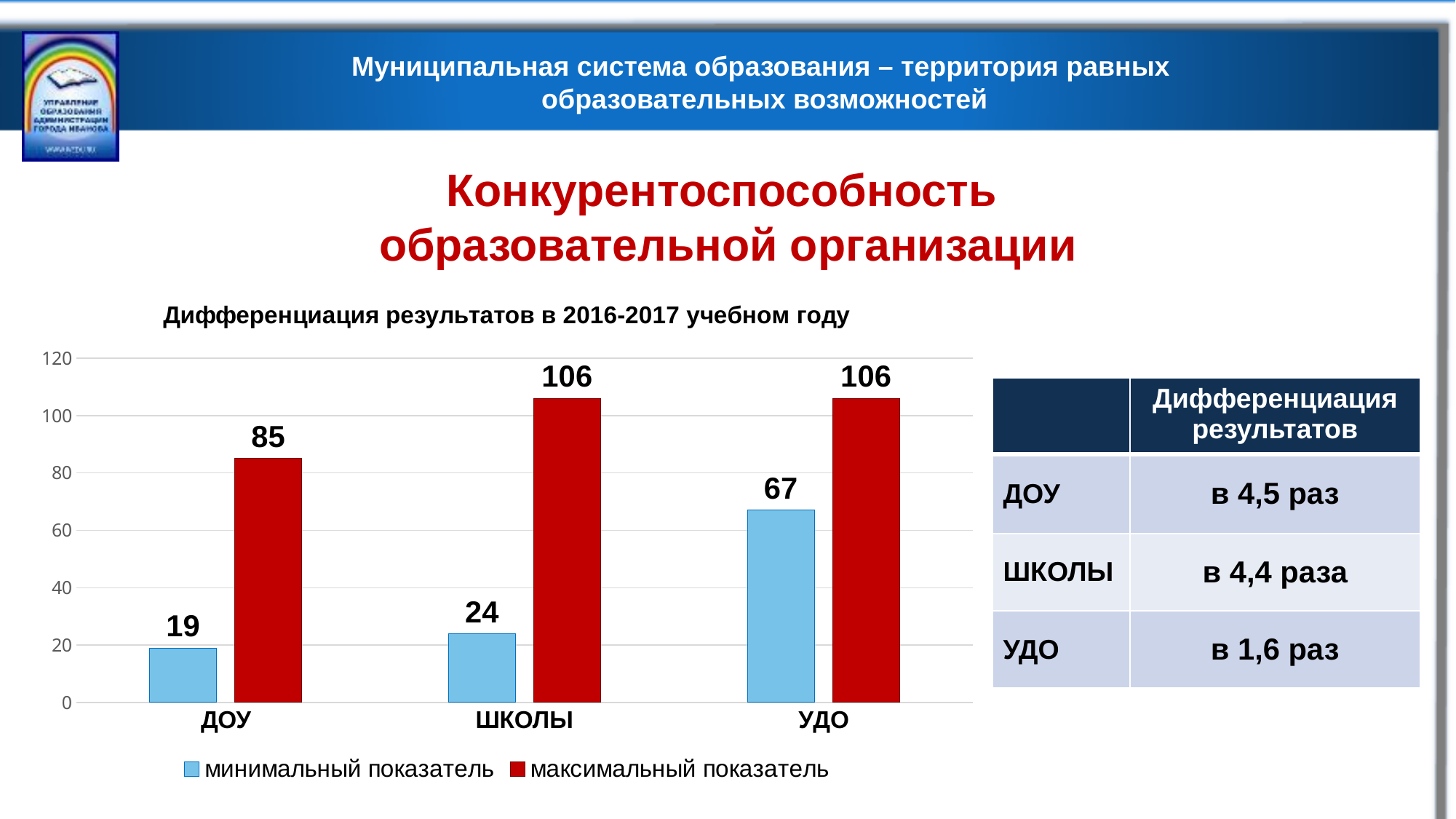
What is the maximum indicator value for ДОУ? 85 What is the minimum indicator (минимальный показатель) value for ДОУ? 19 What is the title of the chart? Дифференциация результатов в 2016-2017 учебном году Which category has the lowest maximum indicator value? ДОУ What type of chart is shown on the slide? bar chart What is the difference between the maximum and minimum indicator for ШКОЛЫ? 82 Which category has the highest minimum indicator value? УДО How many series does the chart legend list? 2 What is the maximum indicator (максимальный показатель) value for ШКОЛЫ? 106 What is the minimum indicator value for УДО? 67 How many categories are shown on the x axis of the chart? 3 Which is larger: the minimum indicator for УДО or the maximum indicator for ДОУ? the maximum indicator for ДОУ